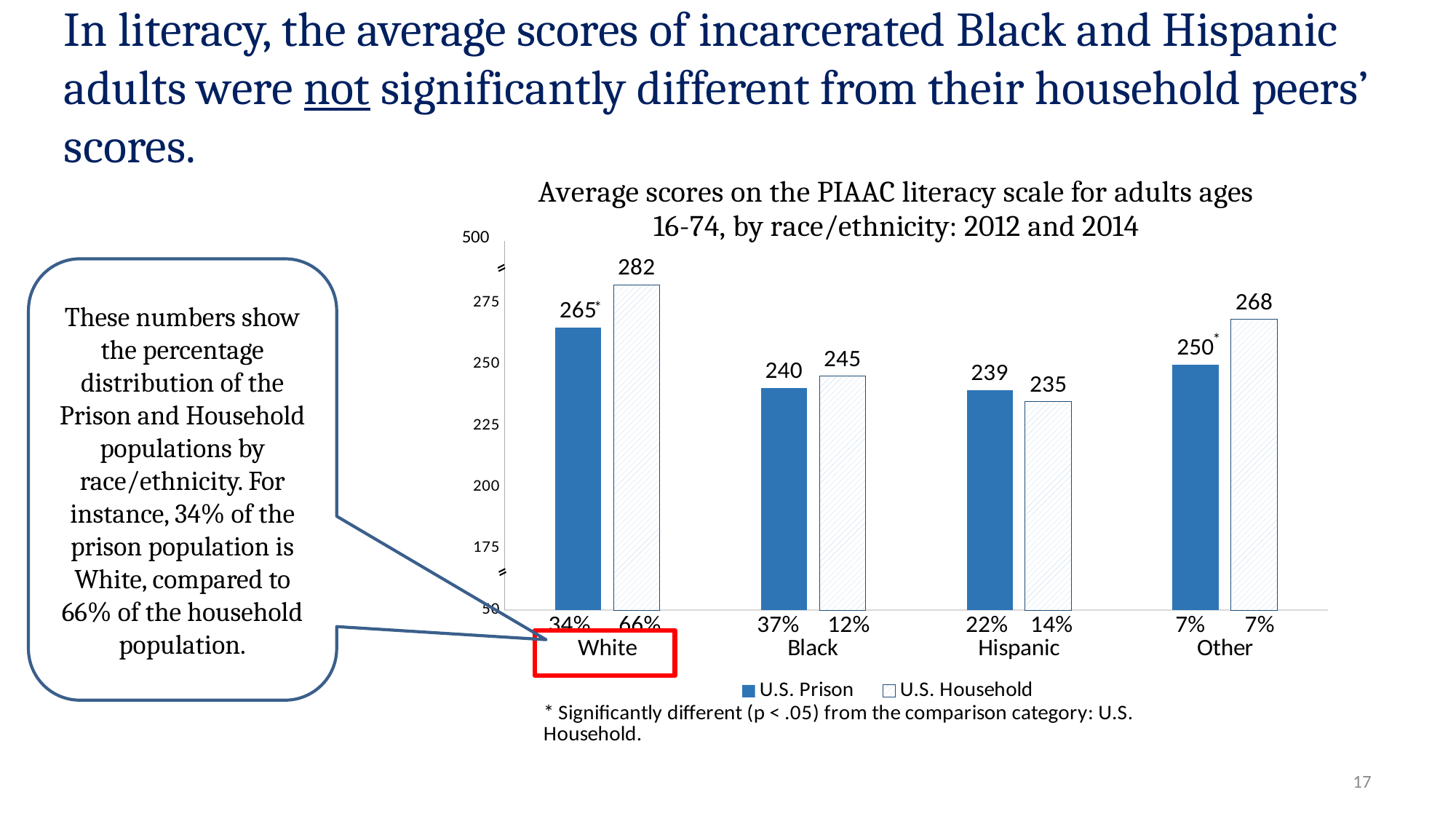
How many race/ethnicity categories are shown on the x axis? 4 What is the average literacy score for the U.S. Household population in the Hispanic category? 235 For the Hispanic category, which is larger: the U.S. Prison score or the U.S. Household score? U.S. Prison Which race/ethnicity category has the highest U.S. Household average literacy score? White What percentage of the prison population is Black, according to the label below the Black bars? 37% How many series does the legend list? 2 Which race/ethnicity category has the lowest U.S. Prison average literacy score? Hispanic What is the average literacy score for the U.S. Household population in the Other category? 268 What is the difference between the U.S. Household and U.S. Prison average literacy scores for the White category? 17 What is the difference between the U.S. Household and U.S. Prison average literacy scores for the Other category? 18 What kind of chart is shown on the slide? Bar chart What is the average literacy score for the U.S. Prison population in the White category? 265